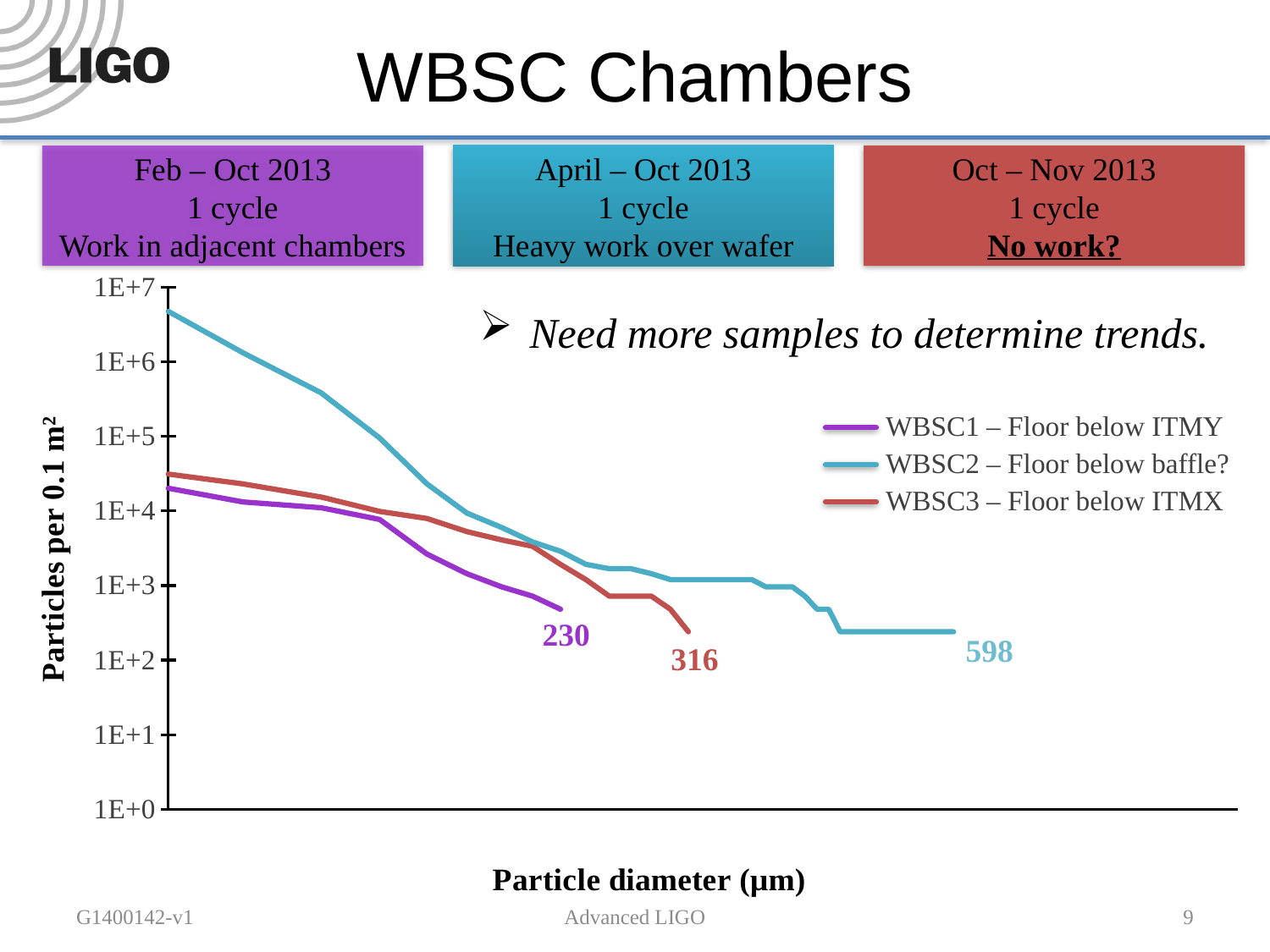
What number is printed at the end of the WBSC1 – Floor below ITMY line? 230 What is the label of the y axis of the chart? Particles per 0.1 m² What is the label of the x axis of the chart? Particle diameter (µm) What kind of chart is shown on the slide? line chart How many series does the chart legend list? 3 Which series has the highest value at the left end of the chart? WBSC2 – Floor below baffle? Is the starting value of the WBSC2 line at the left of the chart greater or less than 1E+6? greater Do the values of the WBSC2 line rise or fall as particle diameter increases along the x axis? fall Is the starting value of the WBSC1 line at the left of the chart greater or less than 1E+5? less What is the difference between the number printed at the end of the WBSC2 line and the number printed at the end of the WBSC1 line? 368 What number is printed at the end of the WBSC3 – Floor below ITMX line? 316 What number is printed at the end of the WBSC2 – Floor below baffle? line? 598